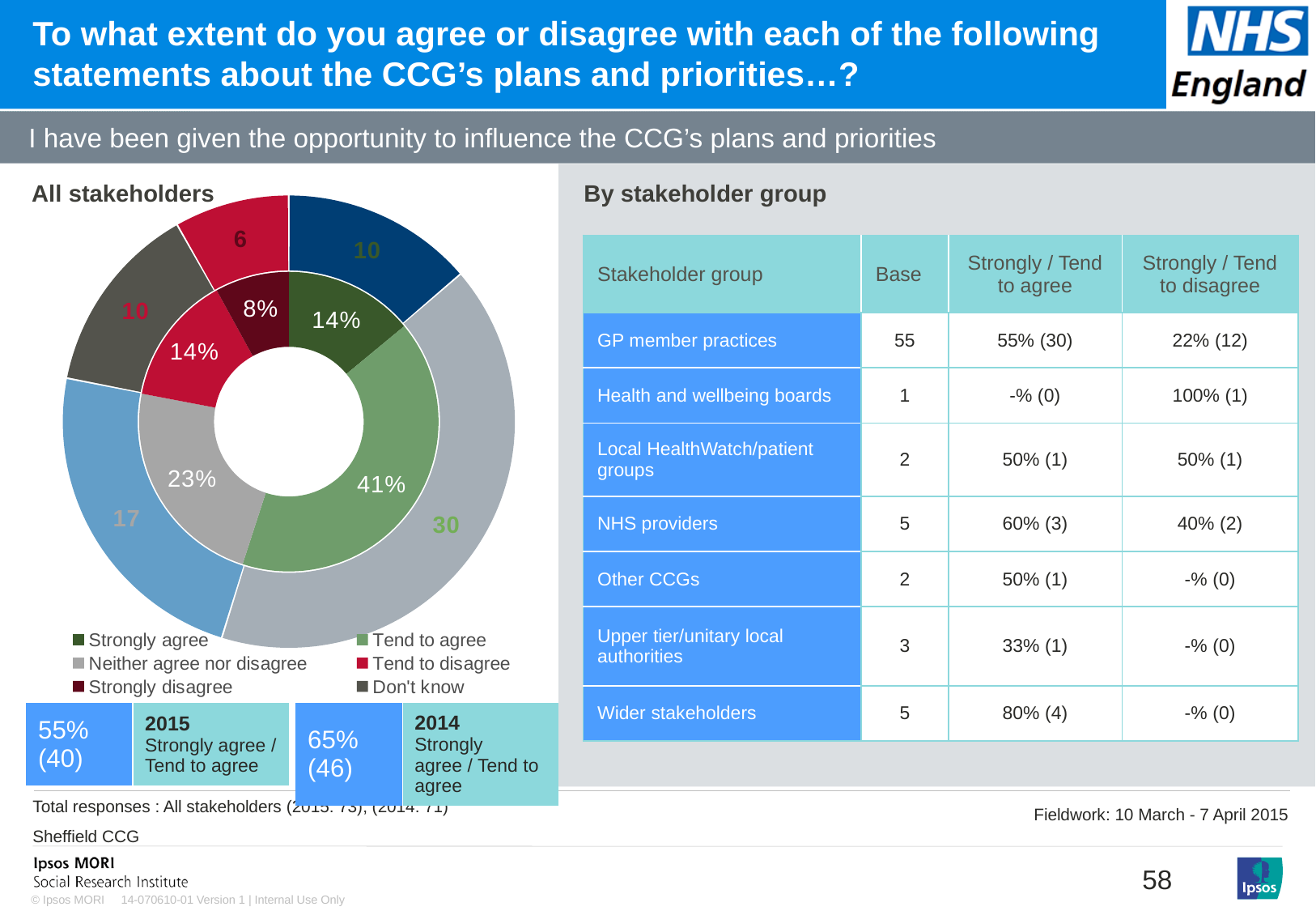
In the 'All stakeholders' chart, what percentage is shown for 'Tend to agree' in the inner ring? 41% In the 'All stakeholders' chart, what percentage is shown for 'Neither agree nor disagree' in the inner ring? 23% In the 'All stakeholders' chart, which response category has the largest share in the inner ring? Tend to agree In the 'All stakeholders' chart, which is larger in the inner ring: 'Strongly agree' or 'Strongly disagree'? Strongly agree According to the summary box below the 'All stakeholders' chart, what was the combined 'Strongly agree / Tend to agree' figure for 2014? 65% (46) In the 'All stakeholders' chart, what is the difference in percentage points between 'Tend to agree' and 'Neither agree nor disagree' in the inner ring? 18 percentage points According to the summary box below the 'All stakeholders' chart, what was the combined 'Strongly agree / Tend to agree' figure for 2015? 55% (40) How many entries does the legend of the 'All stakeholders' chart list? 6 In the 'All stakeholders' chart, what percentage is shown for 'Strongly disagree' in the inner ring? 8% In the 'All stakeholders' chart, what is the largest value labelled on the outer ring? 30 What kind of chart is shown under 'All stakeholders'? Doughnut chart In the 'All stakeholders' chart, which labelled response category has the smallest share in the inner ring? Strongly disagree